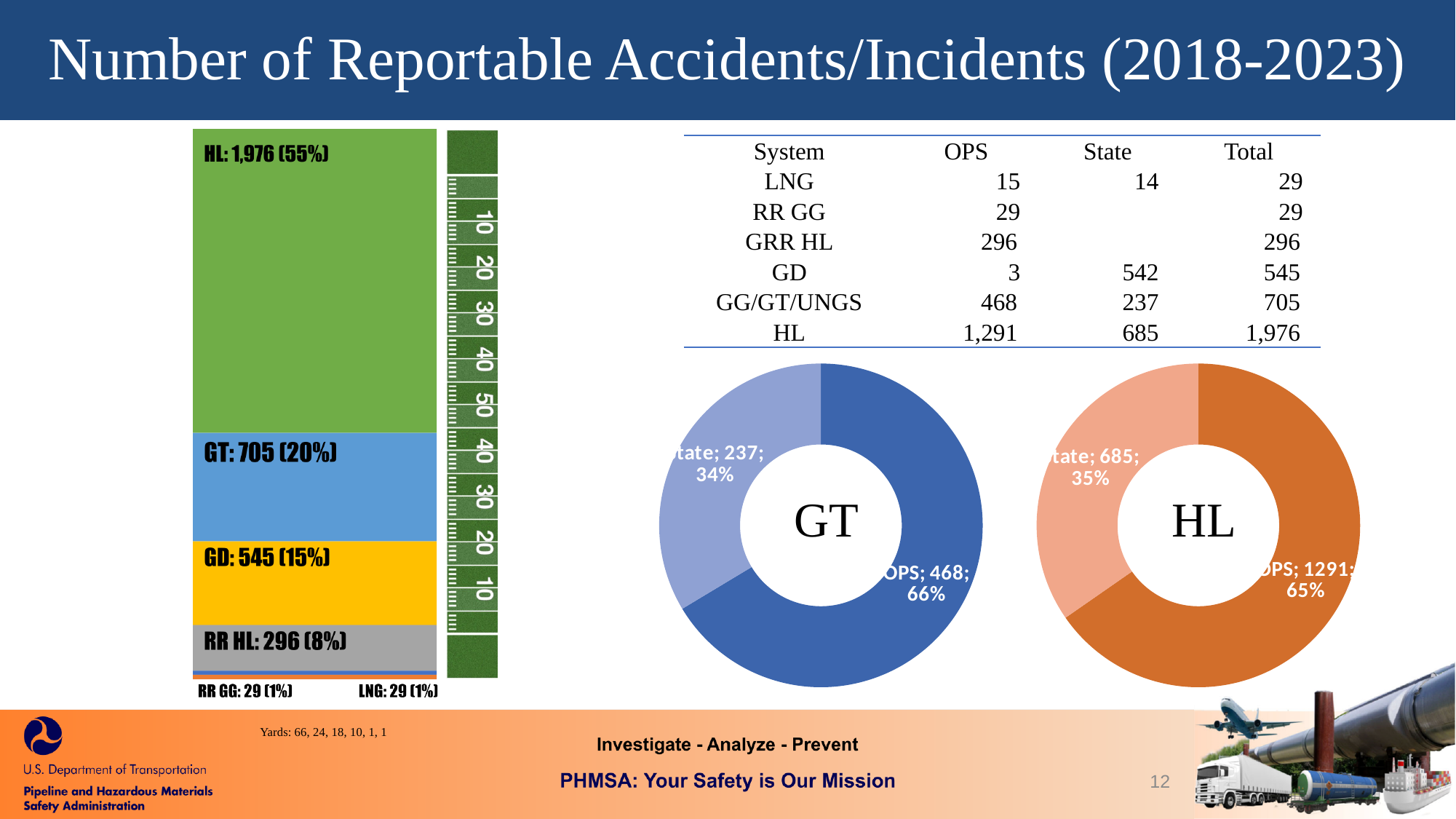
In the HL donut chart, what is the difference between the OPS value and the State value? 606 In the stacked bar chart on the left, what is the difference between the GT value and the GD value? 160 In the GT donut chart, what value and percentage are shown for OPS? 468; 66% In the stacked bar chart on the left, which segment is the largest? HL What type of chart are the two charts labelled GT and HL on the right? Donut (pie) charts In the HL donut chart, what value is shown for State? 685 In the stacked bar chart on the left, what percentage share is shown for RR HL? 8% In the GT donut chart, what percentage is shown for State? 34% How many segments are labelled in the stacked bar chart on the left? 6 In the stacked bar chart on the left, what value is shown for GD? 545 (15%) In the stacked bar chart on the left, what is the value shown for HL? 1,976 (55%) In the stacked bar chart on the left, which is larger, RR HL or GD? GD